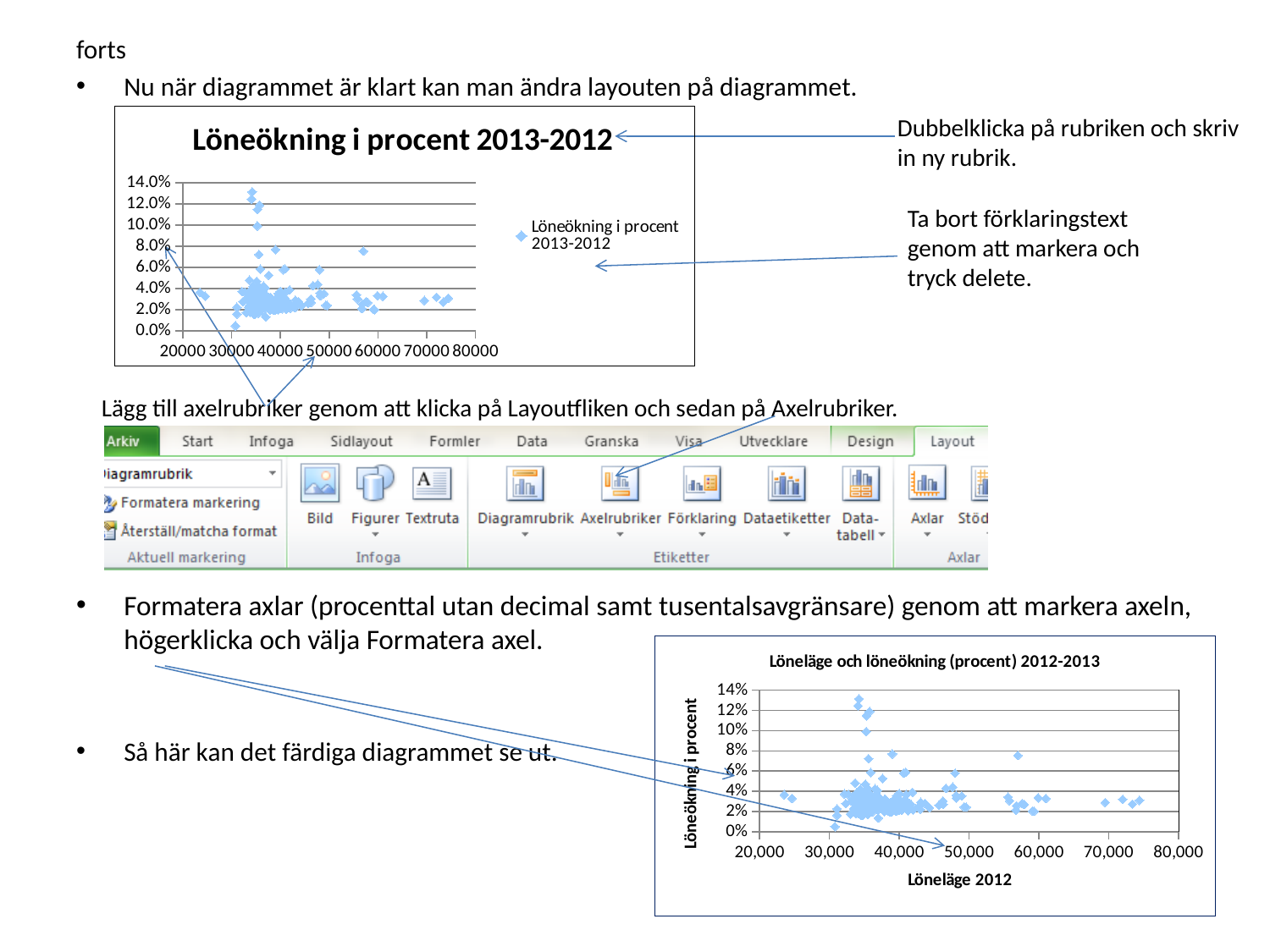
What kind of chart is the bottom chart titled 'Löneläge och löneökning (procent) 2012-2013'? Scatter chart What is the title of the top chart on the slide? Löneökning i procent 2013-2012 In the top chart, is the highest plotted point greater or less than 12.0%? greater In the top chart, what is the highest value shown on the horizontal axis? 80000 In the bottom chart, is the lowest value on the horizontal axis greater or less than 30,000? less In the bottom chart, what is the title of the horizontal axis? Löneläge 2012 In the bottom chart, is the highest plotted point greater or less than 12%? greater In the top chart, how many series does the legend list? 1 What kind of chart is the top chart titled 'Löneökning i procent 2013-2012'? Scatter chart